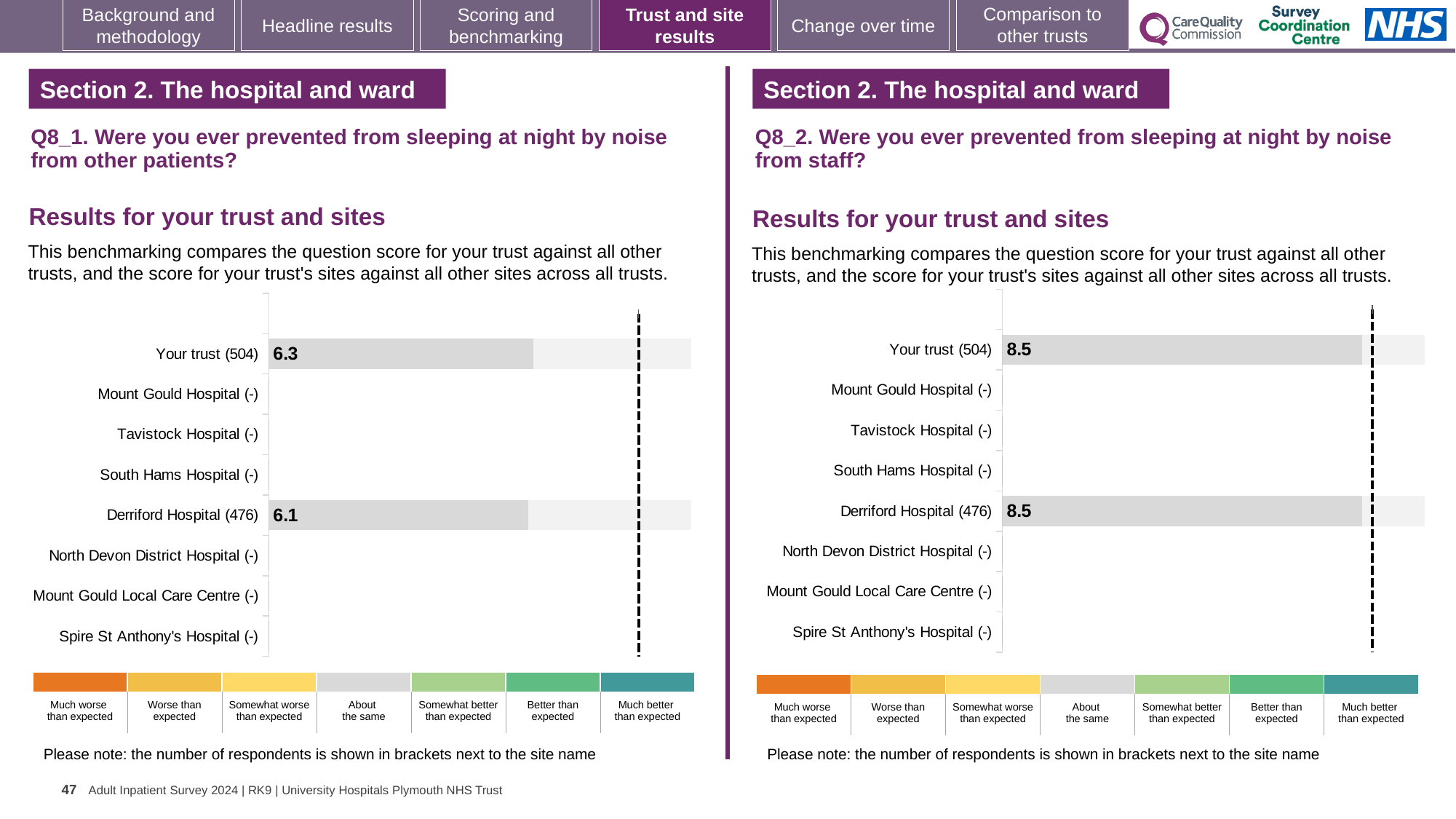
How many benchmark categories are shown in the colour key below the Q8_1 chart (noise from other patients)? 7 In the Q8_2 chart (noise from staff), what is the score for Your trust (504)? 8.5 In the Q8_1 chart (noise from other patients), what is the difference between the score for Your trust and the score for Derriford Hospital? 0.2 How many site/trust categories are listed on the y axis of the Q8_2 chart (noise from staff)? 8 In the Q8_1 chart (noise from other patients), which has the higher score, Your trust or Derriford Hospital? Your trust In the Q8_2 chart (noise from staff), what is the score for Derriford Hospital (476)? 8.5 What kind of chart is used for the Q8_1 results (noise from other patients)? Bar chart In the Q8_1 chart (noise from other patients), what is the score for Your trust (504)? 6.3 In the Q8_1 chart (noise from other patients), what is the score for Derriford Hospital (476)? 6.1 Is the score for Your trust in the Q8_2 chart (noise from staff) greater or less than the score for Your trust in the Q8_1 chart (noise from other patients)? greater In the Q8_1 chart (noise from other patients), how many sites have a plotted score bar? 2 What is the number of respondents shown in brackets for Derriford Hospital in the Q8_2 chart (noise from staff)? 476